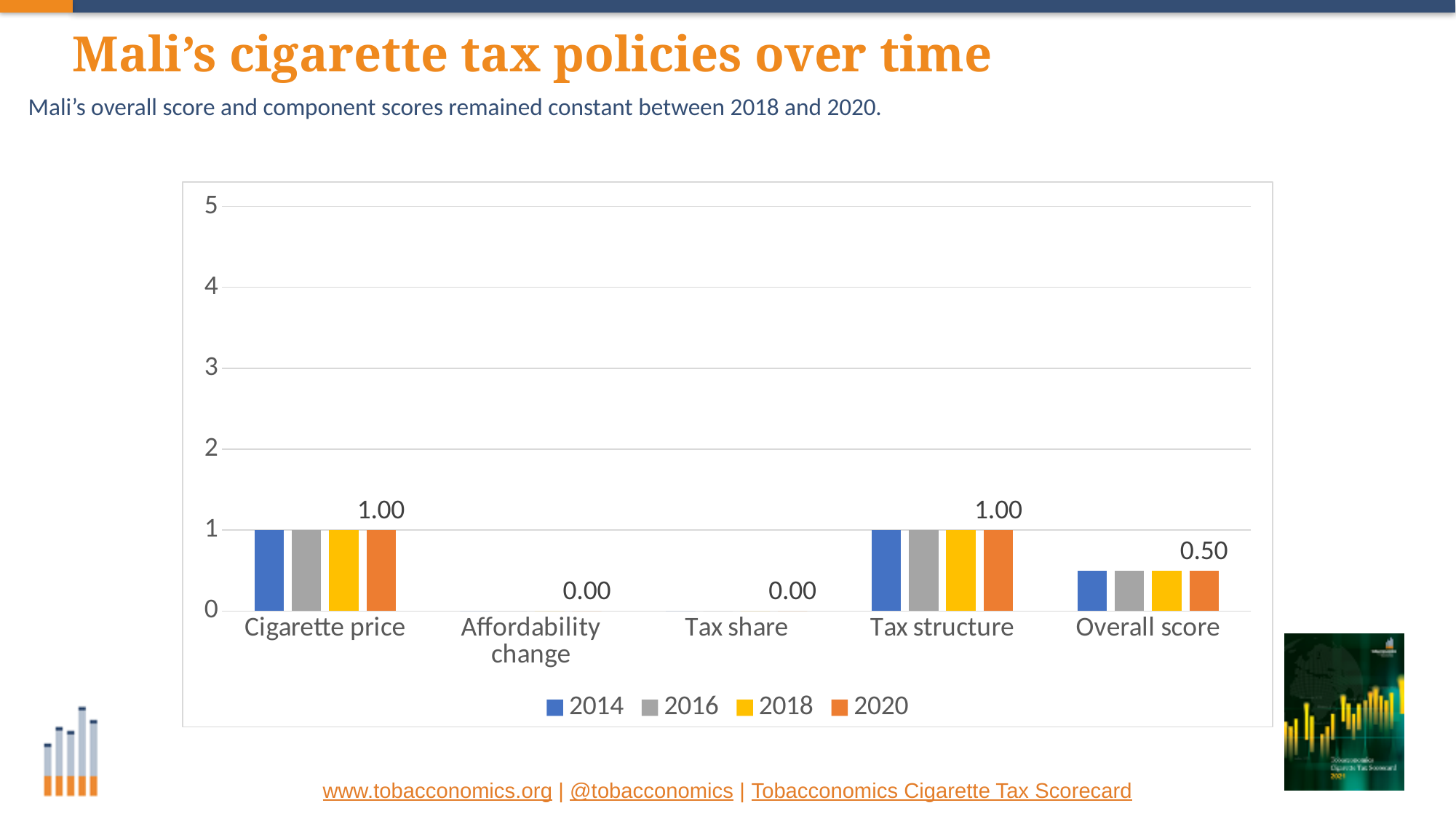
How many categories are shown on the x axis? 5 Is the 2014 value for Overall score greater or less than 1? less How many series does the legend list? 4 What is the 2020 value for Tax share? 0.00 What type of chart is shown on the slide? bar chart Which is larger for 2020: Cigarette price or Overall score? Cigarette price What is the 2020 value for Overall score? 0.50 What is the 2020 value for Tax structure? 1.00 What is the 2020 value for Cigarette price? 1.00 What is the difference between the 2020 values for Tax structure and Overall score? 0.50 Which years are listed in the legend? 2014, 2016, 2018, 2020 What is the 2020 value for Affordability change? 0.00